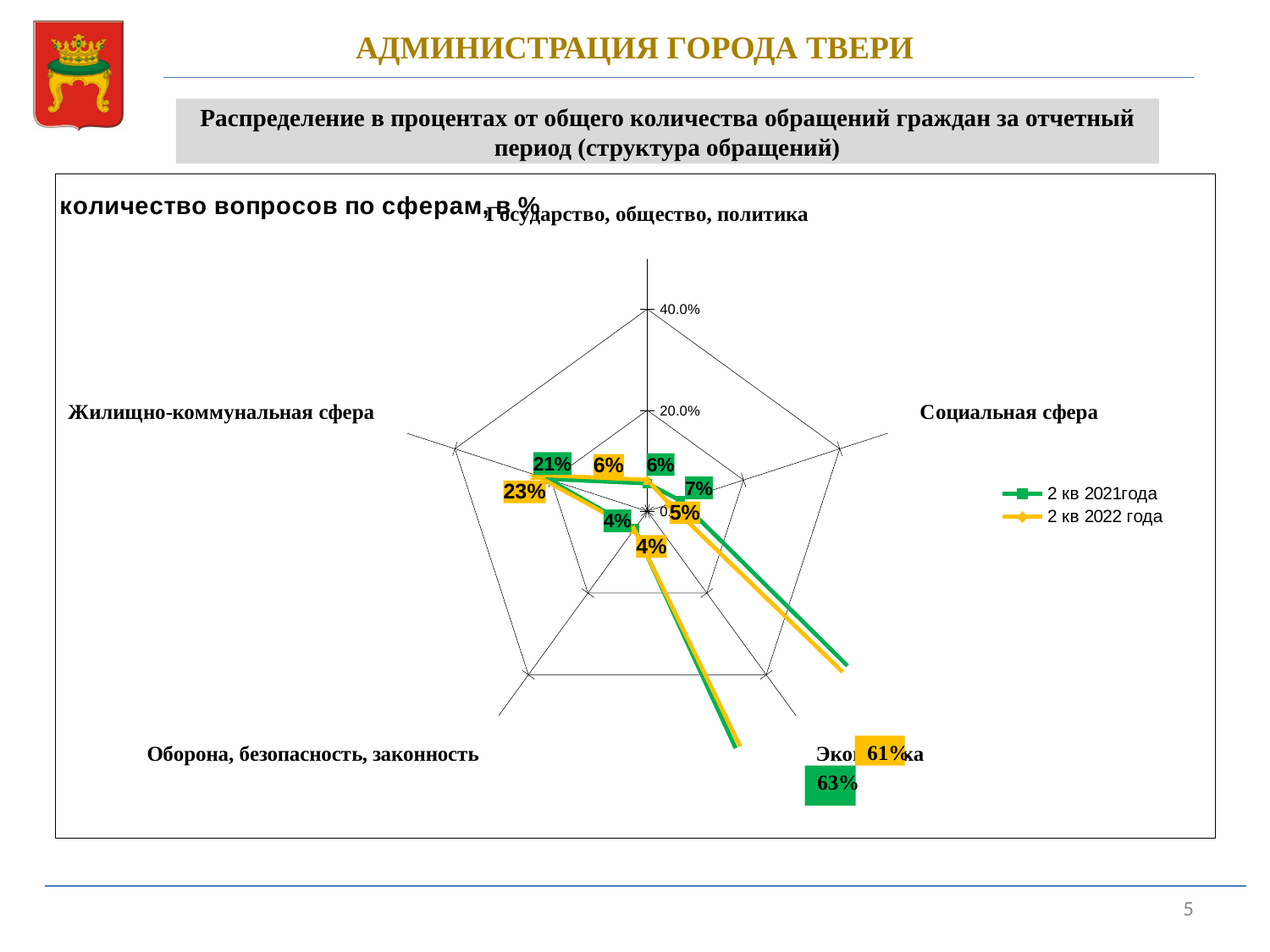
What is the title of the radar chart? количество вопросов по сферам, в % How many categories (axes) does the radar chart have? 5 Which series has the larger value for Социальная сфера, 2 кв 2021года or 2 кв 2022 года? 2 кв 2021года What is the value for Оборона, безопасность, законность in the 2 кв 2022 года series? 4% What is the value for Жилищно-коммунальная сфера in the 2 кв 2021года series? 21% By how much does the 2 кв 2022 года value for Жилищно-коммунальная сфера exceed the 2 кв 2021года value? 2% What is the value for Социальная сфера in the 2 кв 2021года series? 7% What is the value for Государство, общество, политика in the 2 кв 2021года series? 6% What is the value for Социальная сфера in the 2 кв 2022 года series? 5% What is the value for Жилищно-коммунальная сфера in the 2 кв 2022 года series? 23% What kind of chart is shown on the slide? radar chart How many series does the legend of the radar chart list? 2